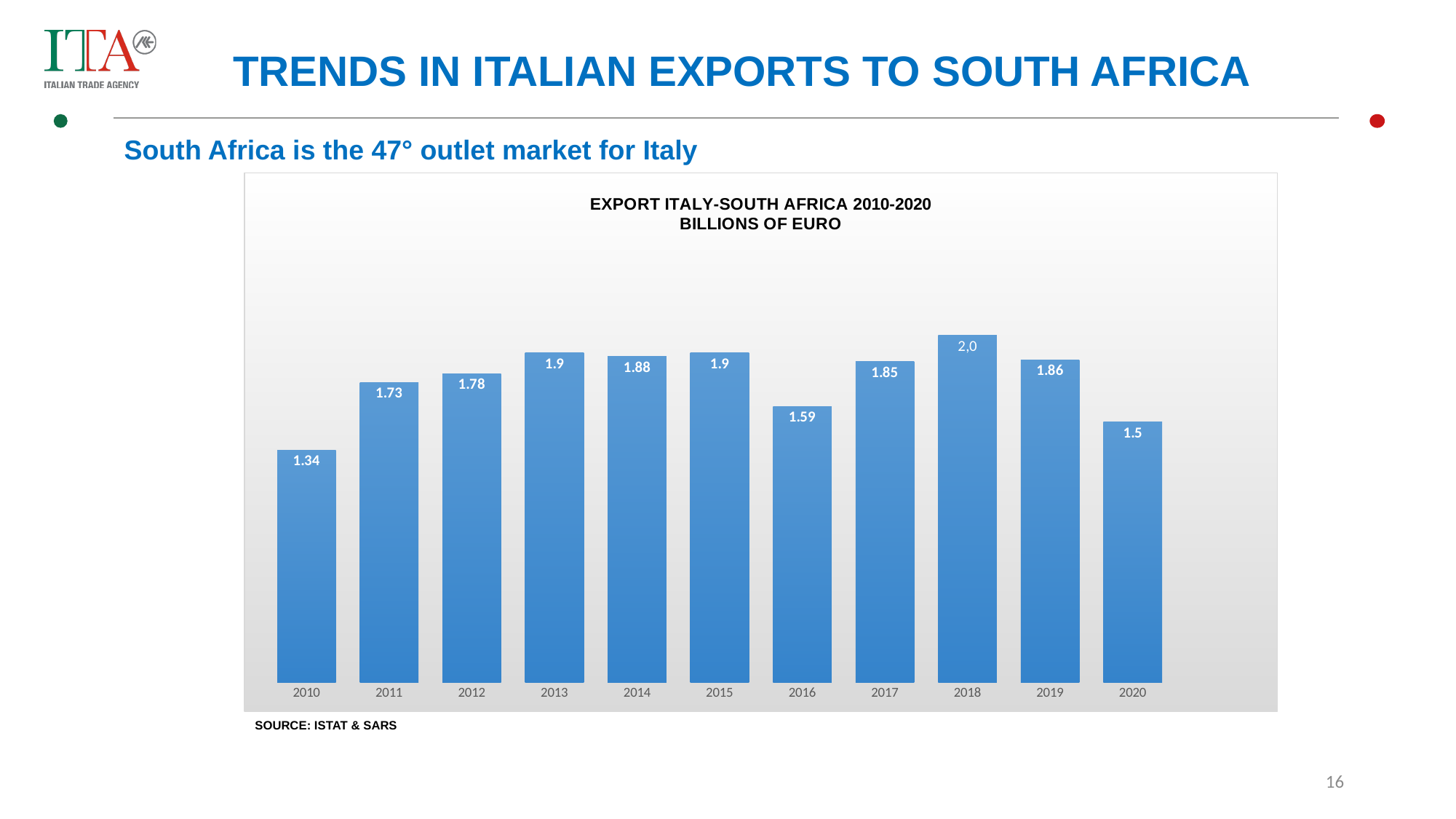
What is the difference between the export values for 2014 and 2016? 0.29 What is the source cited below the chart? ISTAT & SARS What kind of chart is shown on the slide? Bar chart Do the export values rise or fall from 2010 to 2013? Rise How many years are shown on the x axis? 11 What is the export value for 2020? 1.5 Which year has the lowest export value? 2010 What is the title of the chart? EXPORT ITALY-SOUTH AFRICA 2010-2020 BILLIONS OF EURO What is the export value for 2016? 1.59 What is the export value for 2010? 1.34 Which year has a larger export value, 2011 or 2019? 2019 Which year has the highest export value? 2018